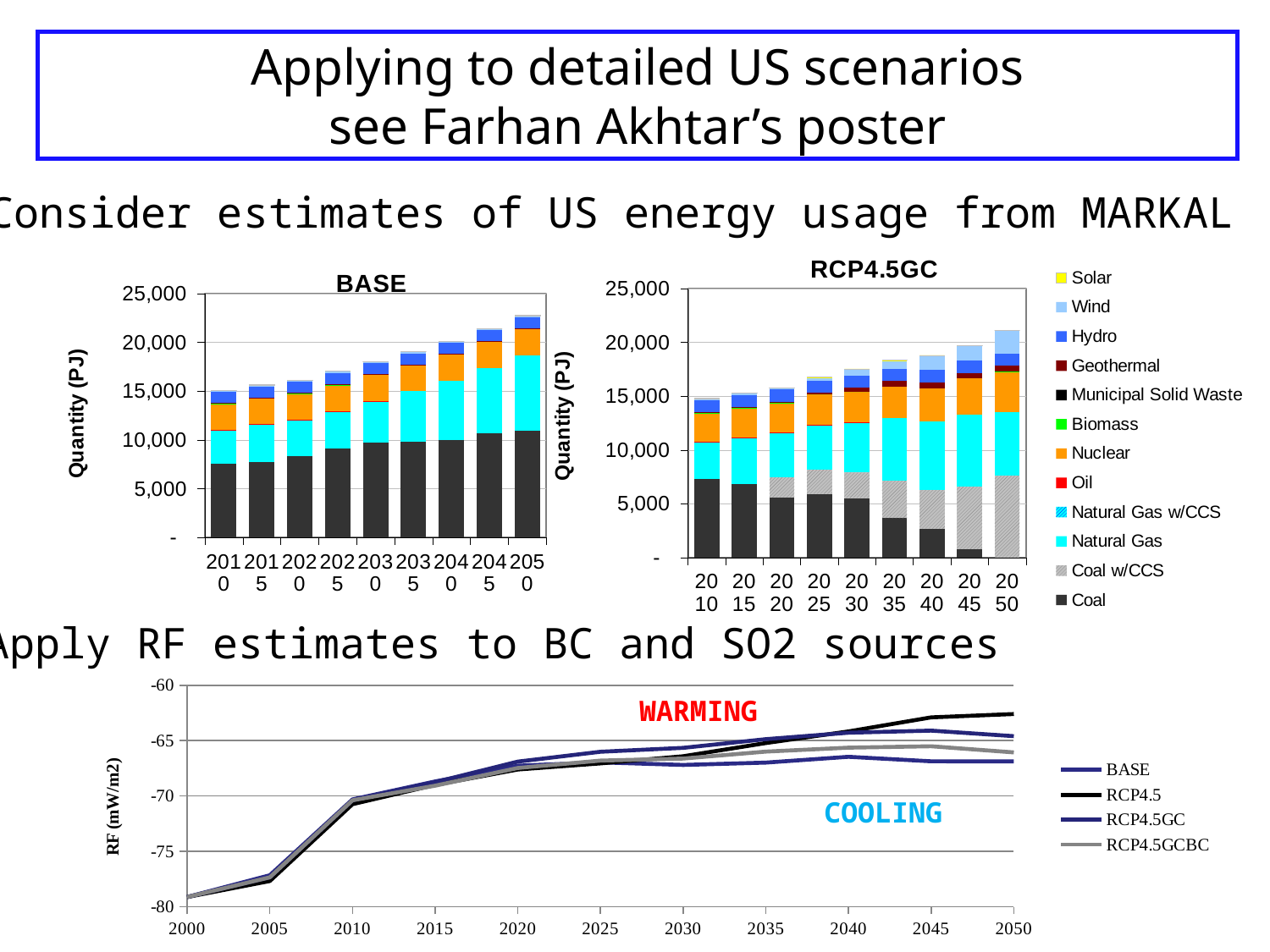
In the bottom RF line chart, do the RF values rise or fall from 2000 to 2050? rise How many years (bars) are shown on the x axis of the BASE chart? 9 How many series does the legend of the bottom RF line chart list? 4 What kind of chart is the BASE chart? bar chart In the BASE chart, does the total quantity rise or fall from 2010 to 2050? rise In the BASE chart, is the total for 2050 greater or less than 20,000? greater What is the y-axis label of the BASE chart? Quantity (PJ) In the bottom RF line chart, is the RF value in 2000 greater or less than -75? less In the RCP4.5GC chart, is the total for 2040 greater or less than 20,000? less In the bottom RF line chart, which series has the highest RF value in 2050? RCP4.5 What kind of chart is the bottom chart showing RF (mW/m2)? line chart How many series does the legend of the RCP4.5GC chart list? 12